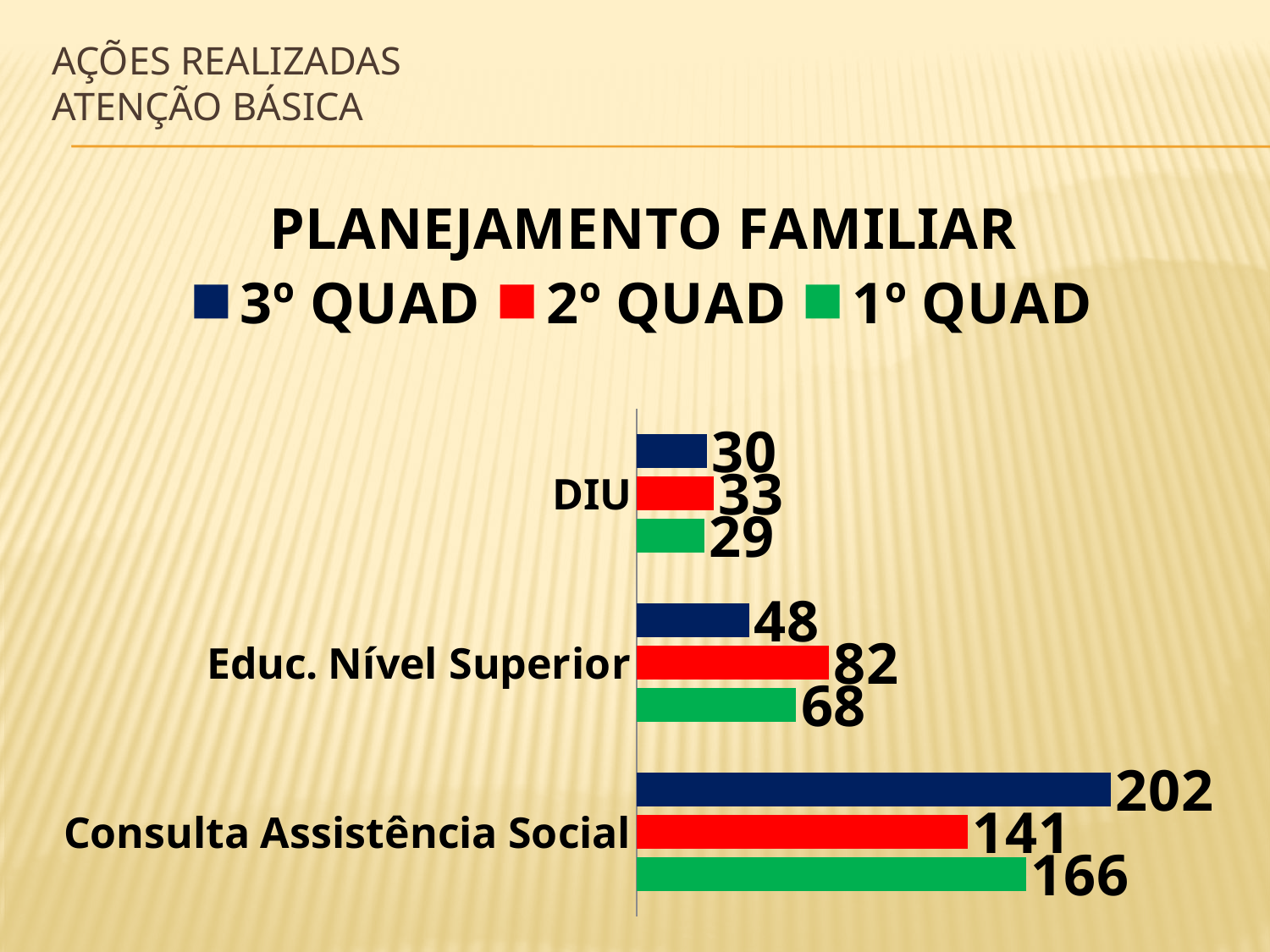
What kind of chart is shown on the slide? Bar chart What is the value for DIU in 2º QUAD? 33 Which is larger for Educ. Nível Superior: the 2º QUAD value or the 3º QUAD value? 2º QUAD What is the title of the chart? PLANEJAMENTO FAMILIAR Which colour represents 1º QUAD in the legend? Green Which category has the highest value in 3º QUAD? Consulta Assistência Social Which category has the lowest value in 1º QUAD? DIU What is the value for Educ. Nível Superior in 1º QUAD? 68 How many series does the legend list? 3 What is the difference between the 3º QUAD and 2º QUAD values for Consulta Assistência Social? 61 How many categories are shown on the chart? 3 What is the value for Consulta Assistência Social in 3º QUAD? 202